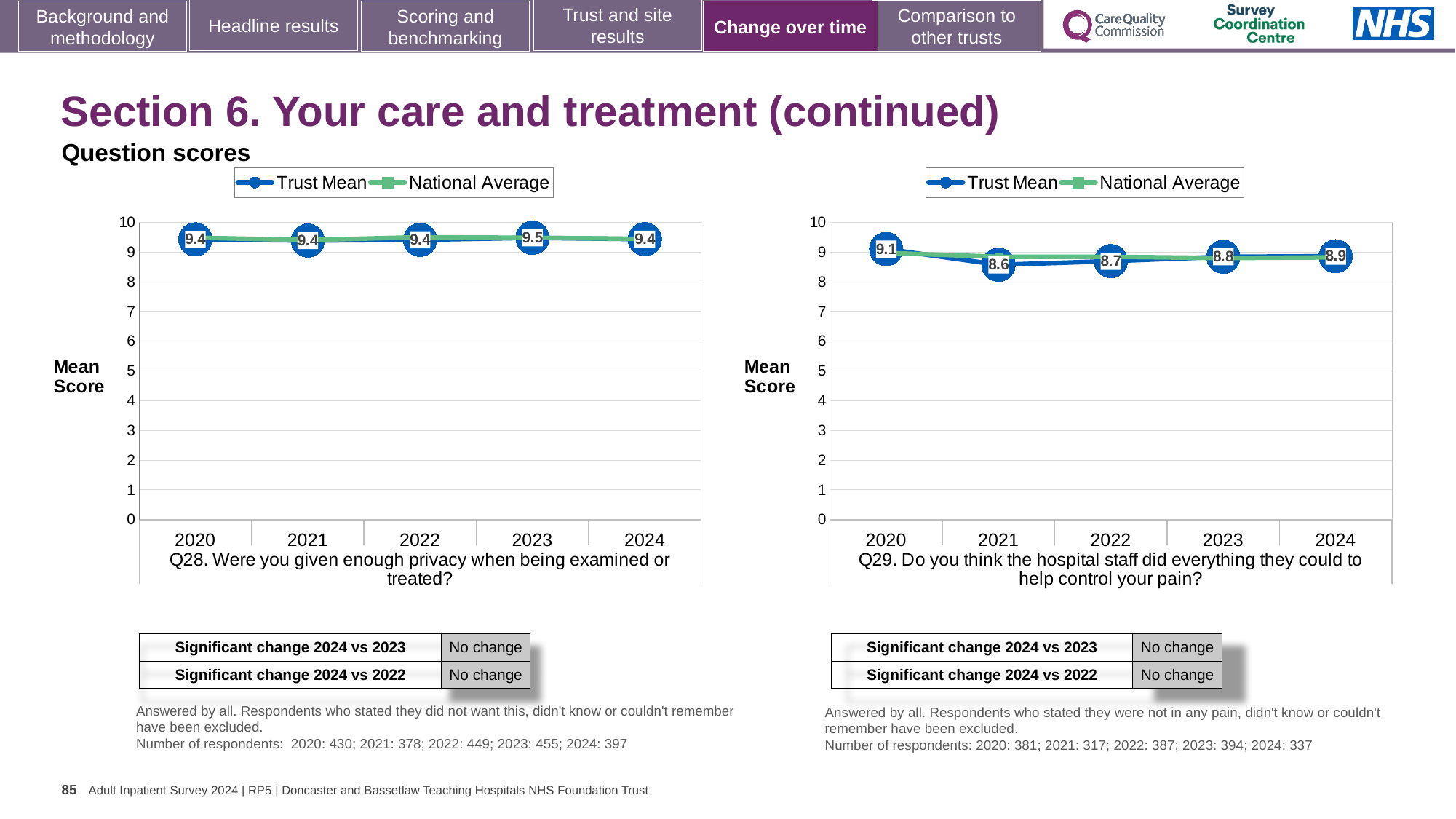
In the Q29 chart, what is the Trust Mean score for 2024? 8.9 In the Q29 chart, does the Trust Mean rise or fall from 2021 to 2024? Rise How many years are plotted on the x axis of the Q28 chart? 5 In the Q28 chart, is the Trust Mean score for 2023 larger or smaller than the score for 2024? larger In the Q28 chart, what is the Trust Mean score for 2023? 9.5 In the Q29 chart, is the Trust Mean value for 2021 greater or less than 9? less In the Q29 chart, which year has the highest Trust Mean score? 2020 In the Q29 chart, what is the Trust Mean score for 2021? 8.6 In the Q29 chart, which year has the lowest Trust Mean score? 2021 What kind of chart is used for Q28? Line chart How many series does the legend of the Q29 chart list? 2 In the Q29 chart, what is the difference between the Trust Mean scores for 2020 and 2021? 0.5